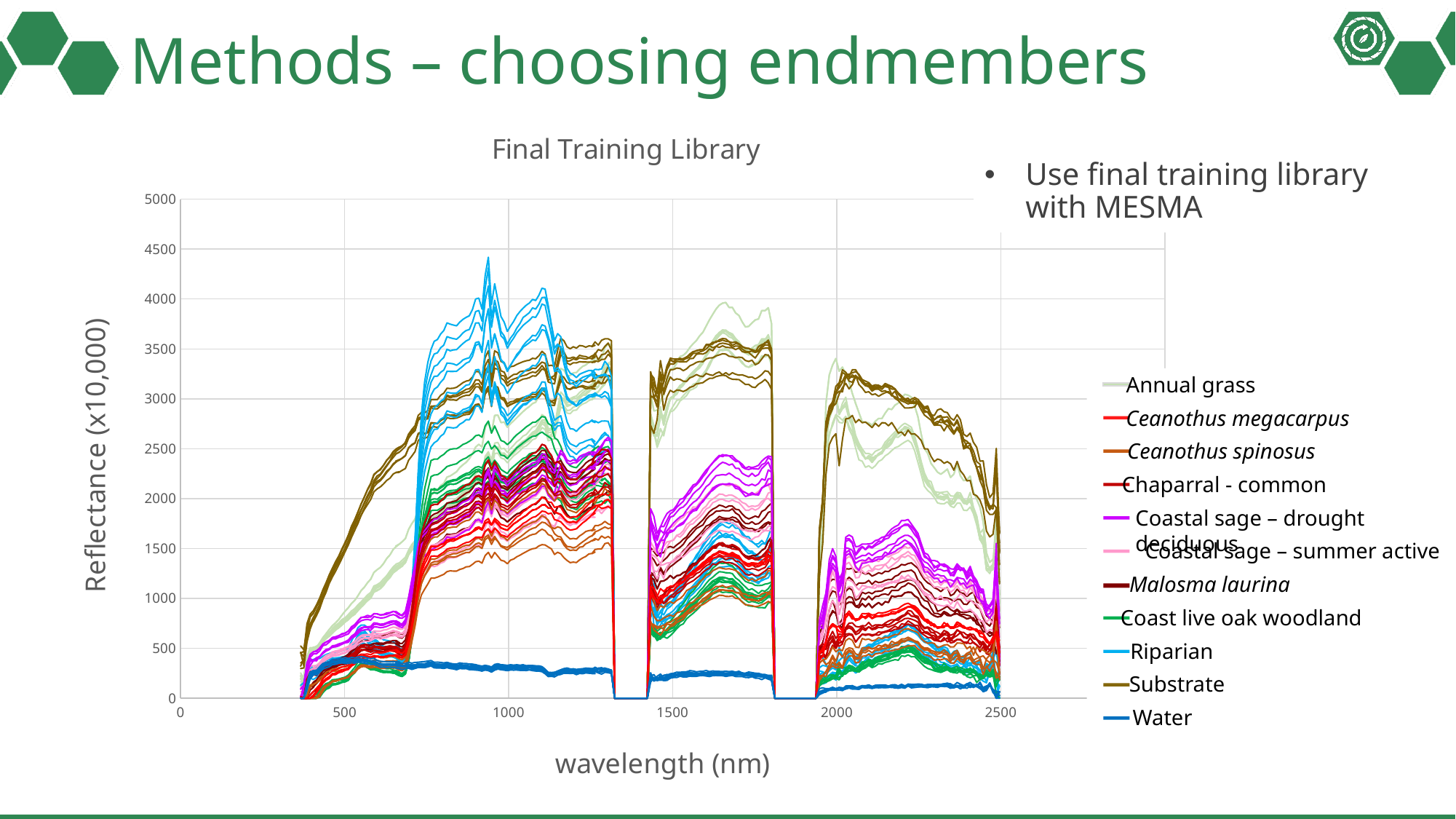
Does the Water series rise or fall between 1000 nm and 2500 nm? fall Is the value for Substrate at around 1650 nm greater or less than 3000? greater What is the label of the x axis? wavelength (nm) Is the value for Water at 1000 nm greater or less than 500? less Is the peak value for Riparian near 950 nm greater or less than 4000? greater At 1000 nm, which series has the larger reflectance, Riparian or Water? Riparian What kind of chart is shown on the slide? line chart How many series does the chart's legend list? 11 Which series reaches the highest peak reflectance on the chart? Riparian Which series has the lowest reflectance values across the whole wavelength range? Water What is the title of the chart? Final Training Library